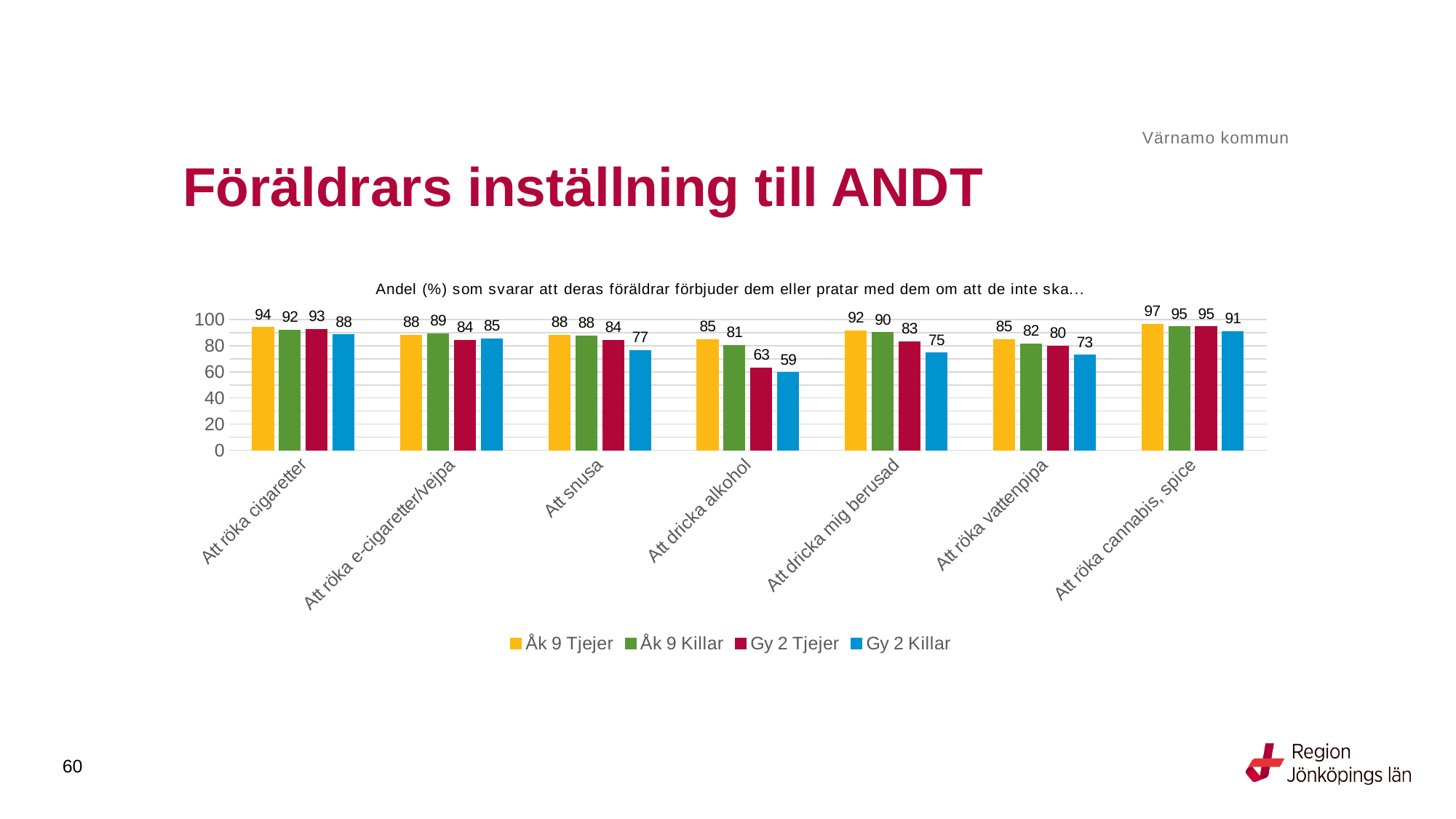
Which colour represents the series Gy 2 Killar in the chart? Blue Is the value for Gy 2 Killar in the category "Att röka vattenpipa" greater or less than 80? less Which category has the lowest value for Gy 2 Tjejer? Att dricka alkohol How many categories are shown on the x axis of the chart? 7 How many series does the legend list? 4 What is the difference between the Åk 9 Tjejer and Gy 2 Killar values in the category "Att dricka alkohol"? 26 What kind of chart is shown on the slide? Bar chart In the category "Att snusa", which is larger: the value for Gy 2 Tjejer or the value for Gy 2 Killar? Gy 2 Tjejer What is the value for Åk 9 Tjejer in the category "Att röka cannabis, spice"? 97 Which category has the highest value for Gy 2 Killar? Att röka cannabis, spice What is the value for Gy 2 Tjejer in the category "Att dricka mig berusad"? 83 What is the value for Gy 2 Killar in the category "Att dricka alkohol"? 59